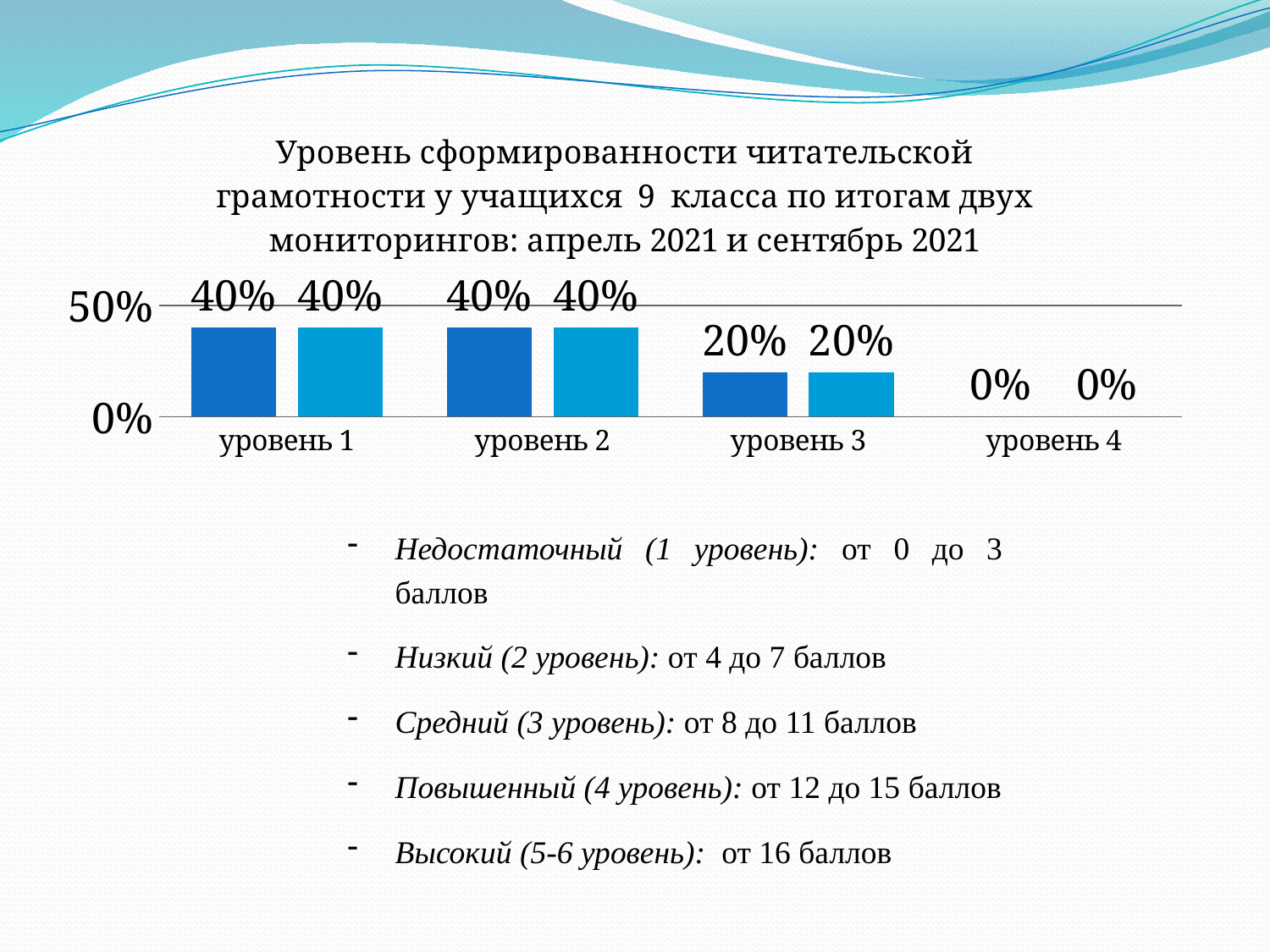
Do the values rise or fall moving from уровень 1 to уровень 4 along the x axis? fall What is the highest value labelled on the chart's vertical axis? 50% What is the difference between the dark blue bar for уровень 1 and the dark blue bar for уровень 3? 20% What is the value of the light blue (right) bar for уровень 2? 40% What type of chart is shown on the slide? bar chart What is the value of the light blue (right) bar for уровень 3? 20% What is the value of the dark blue (left) bar for уровень 1? 40% How many bars are shown for each level in the chart? 2 Which level has the lowest values in the chart? уровень 4 What value is shown for уровень 4 in the chart? 0% Which is larger: the light blue bar for уровень 2 or the light blue bar for уровень 3? уровень 2 How many categories (levels) are shown on the x axis of the chart? 4